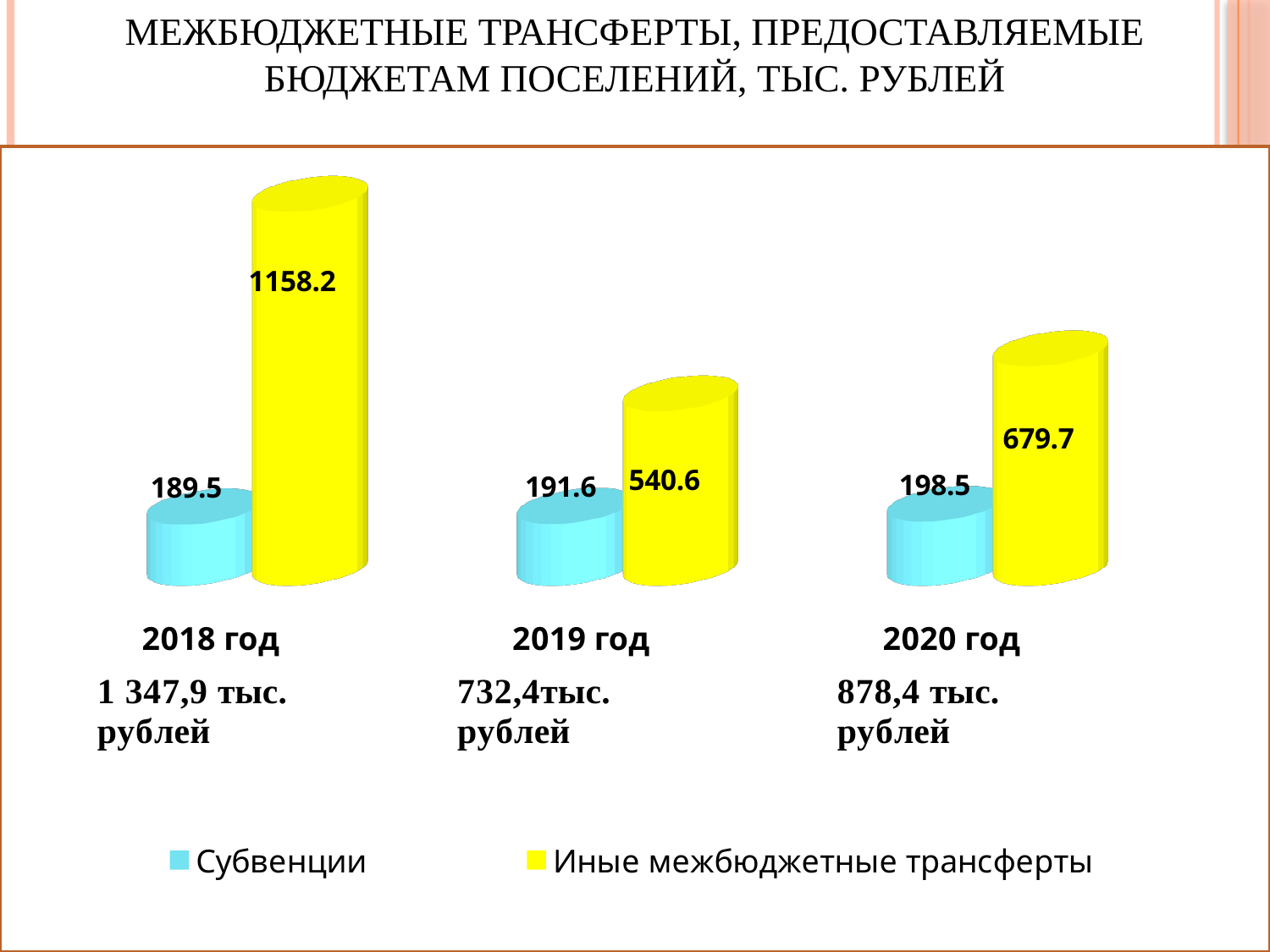
What is the value for Субвенции in 2020 год? 198.5 In which year is the value for Иные межбюджетные трансферты highest? 2018 год In which year is the value for Иные межбюджетные трансферты lowest? 2019 год Which is larger in 2019 год: Субвенции or Иные межбюджетные трансферты? Иные межбюджетные трансферты What is the value for Субвенции in 2018 год? 189.5 How many series does the legend list? 2 What is the difference between Иные межбюджетные трансферты and Субвенции in 2018 год? 968.7 Which colour represents Субвенции in the chart? blue What is the value for Иные межбюджетные трансферты in 2020 год? 679.7 What is the value for Иные межбюджетные трансферты in 2019 год? 540.6 How many years are shown on the chart? 3 What kind of chart is shown on the slide? bar chart